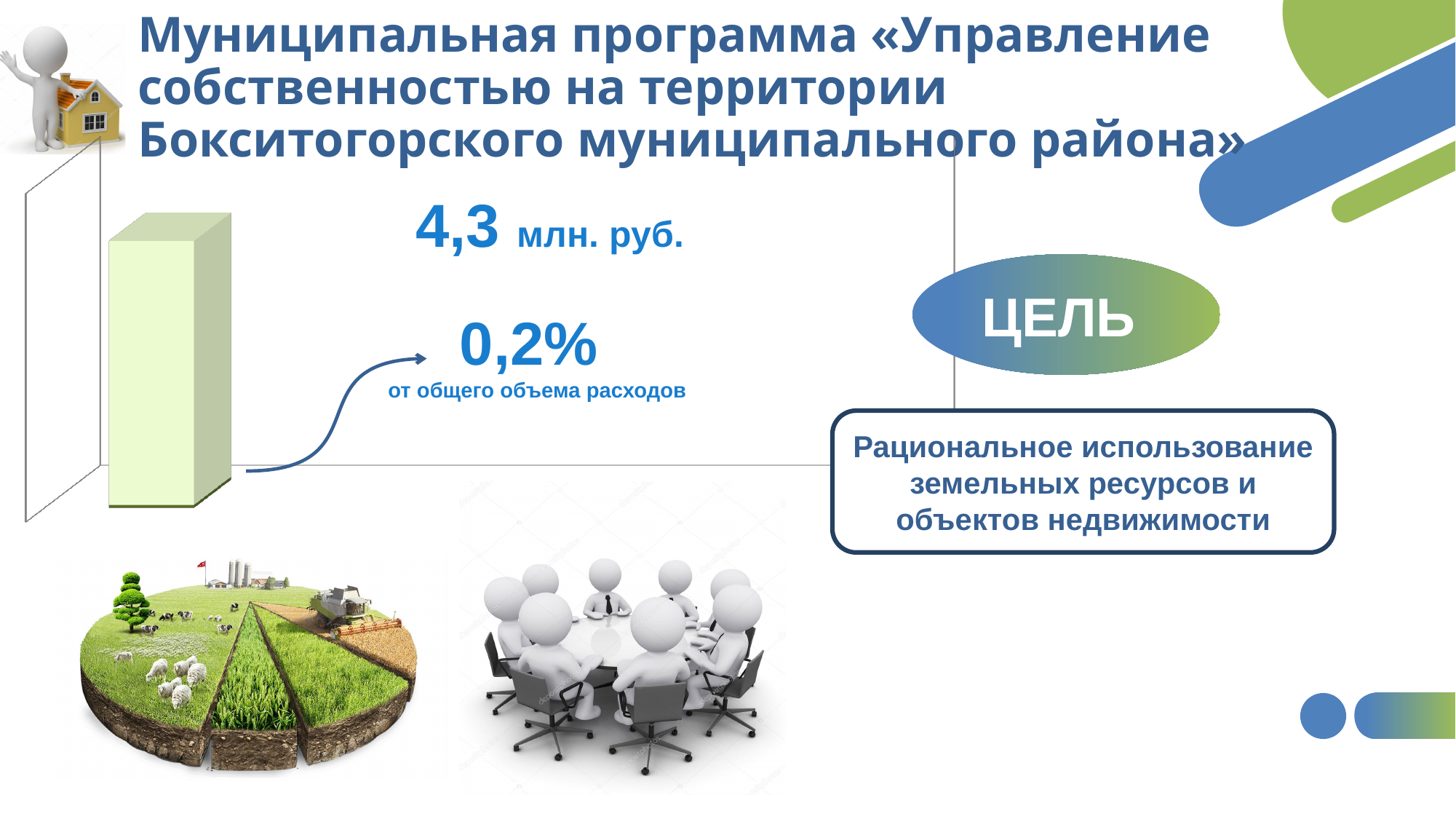
What text is printed under the 0,2% label next to the bar? от общего объема расходов What colour is the bar on the slide? light green What value in million rubles is printed above the bar on the slide? 4,3 млн. руб. How many bars does the chart on the slide contain? 1 What kind of chart is shown on the left of the slide? bar chart What percentage of total expenditure does the bar on the slide represent, according to the label? 0,2%